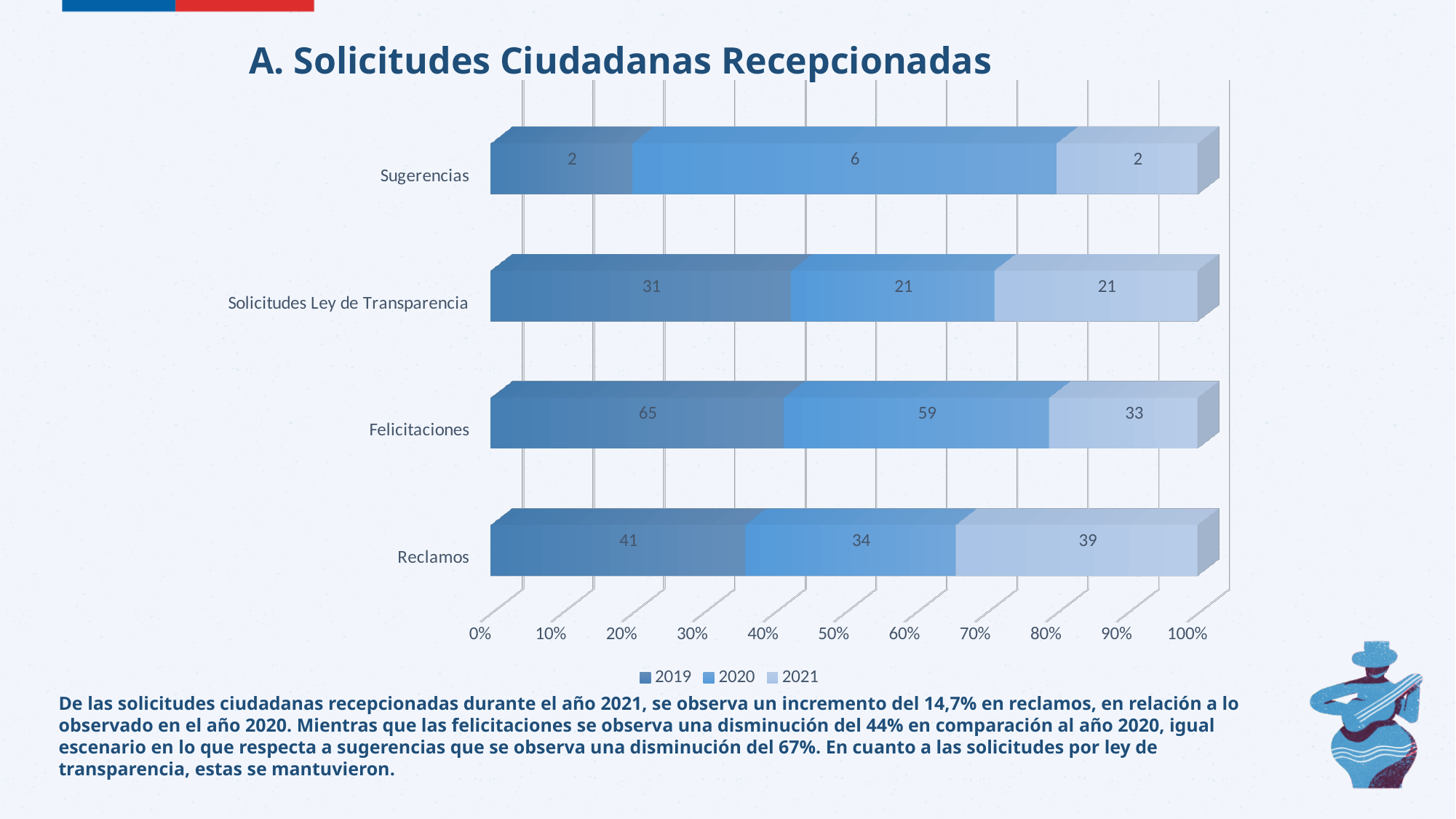
Which category has the highest value in the 2020 series? Felicitaciones How many categories are shown on the chart? 4 What is the title of the chart? A. Solicitudes Ciudadanas Recepcionadas What kind of chart is shown on the slide? Stacked bar chart How many series does the legend list? 3 What is the difference between the 2019 and 2021 values for Felicitaciones? 32 What is the value for Reclamos in the 2021 series? 39 Which category has the lowest value in the 2019 series? Sugerencias What is the total of the three values in the Reclamos bar? 114 What is the value for Felicitaciones in the 2019 series? 65 What is the value for Solicitudes Ley de Transparencia in the 2020 series? 21 Which is larger for Reclamos: the 2020 value or the 2021 value? 2021